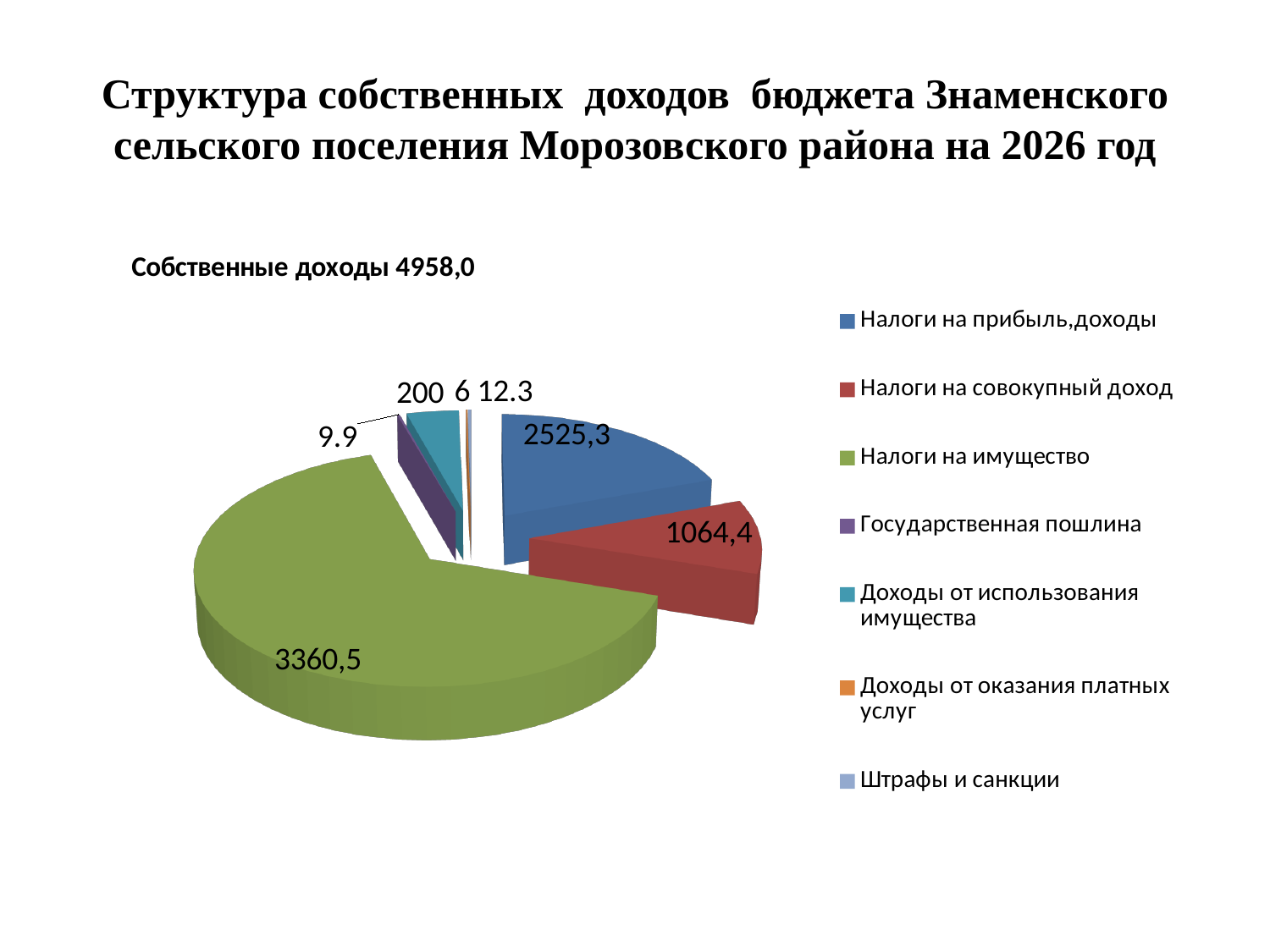
What is the value labelled for Государственная пошлина? 9.9 What is the smallest value labelled on the pie chart? 6 What kind of chart is shown on the slide? pie chart What is the value labelled for Налоги на прибыль,доходы? 2525,3 Which is larger, Налоги на прибыль,доходы or Налоги на совокупный доход? Налоги на прибыль,доходы What is the difference between the values for Налоги на имущество and Налоги на прибыль,доходы? 835,2 What is the value labelled for Доходы от использования имущества? 200 What is the value labelled for Налоги на имущество? 3360,5 What total for Собственные доходы is printed above the chart? 4958,0 Which category has the largest slice of the pie? Налоги на имущество How many categories does the legend list? 7 What is the value labelled for Налоги на совокупный доход? 1064,4